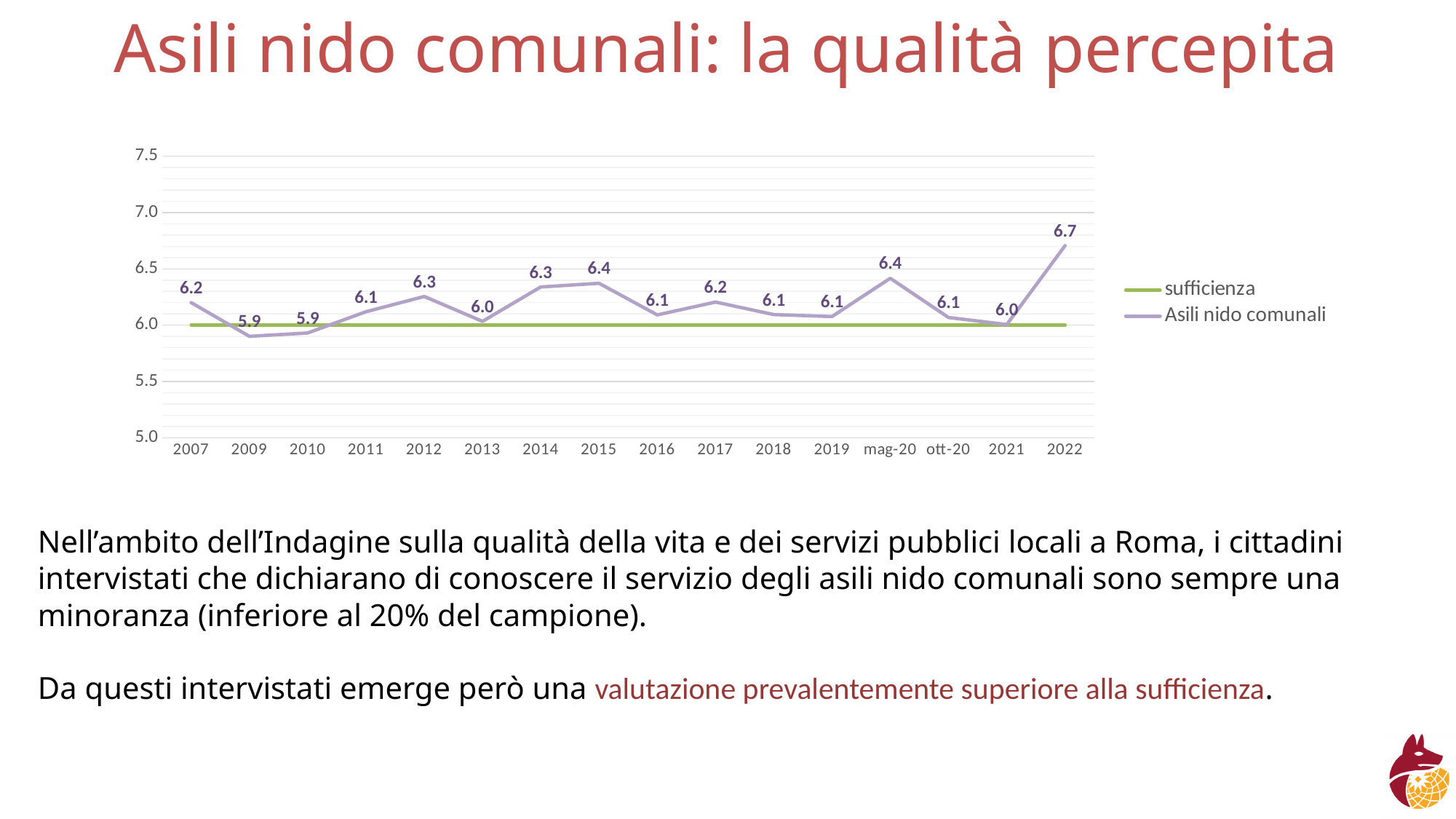
What is the value for Asili nido comunali in 2013? 6.0 Does the Asili nido comunali value rise or fall from 2021 to 2022? rise What type of chart is shown on the slide? line chart What is the value for Asili nido comunali in mag-20? 6.4 What is the difference between the Asili nido comunali values for 2022 and 2021? 0.7 What is the value for Asili nido comunali in 2007? 6.2 Which year has the larger Asili nido comunali value, 2012 or 2013? 2012 How many time points are shown on the x axis? 16 What is the difference between the Asili nido comunali values for 2015 and 2013? 0.4 In which year does Asili nido comunali reach its highest value? 2022 What is the value for Asili nido comunali in 2022? 6.7 How many series does the legend list? 2